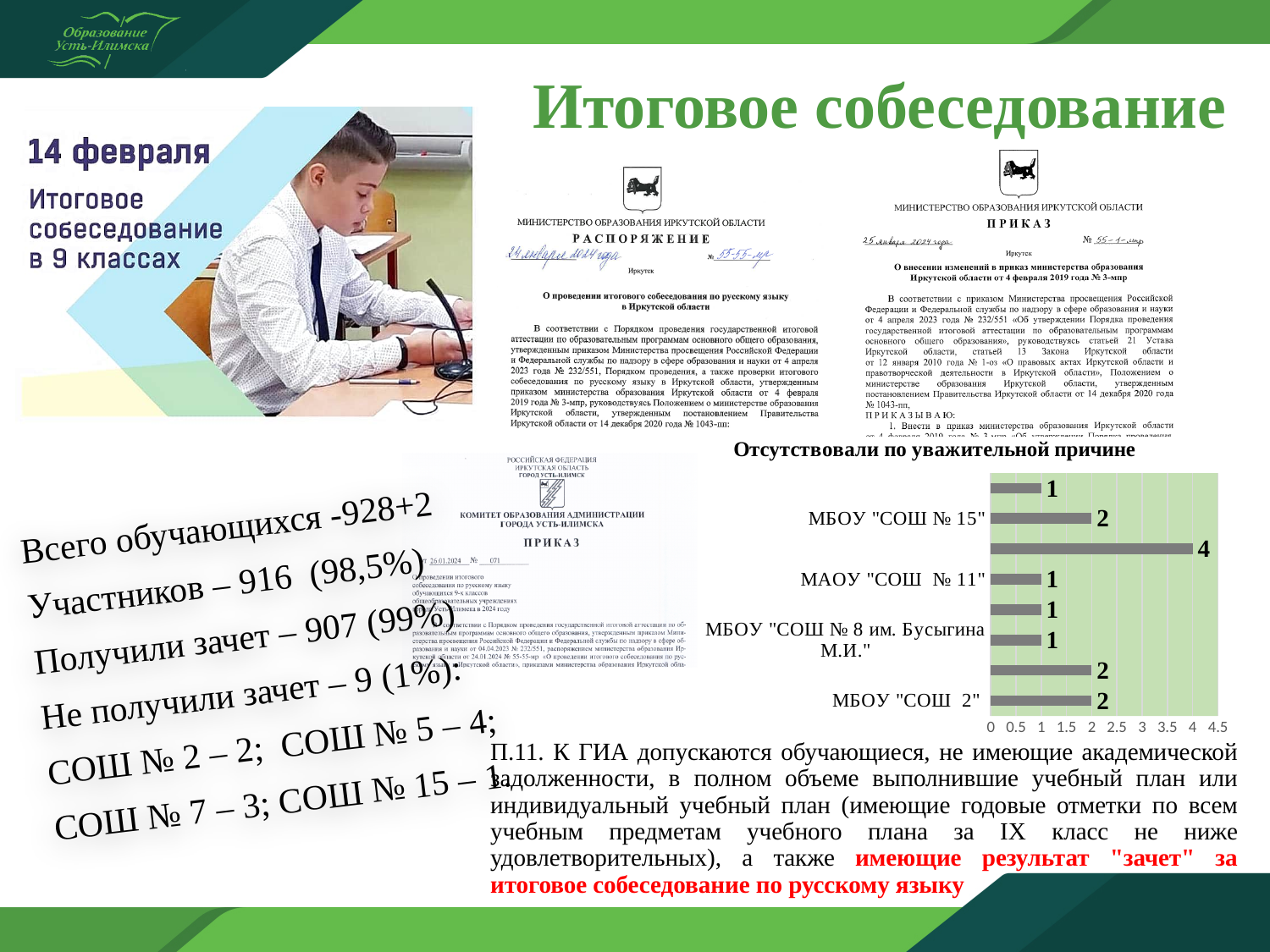
In the chart "Отсутствовали по уважительной причине", what is the value for МБОУ "СОШ № 8 им. Бусыгина М.И."? 1 In the chart "Отсутствовали по уважительной причине", is the value for МБОУ "СОШ № 15" greater or less than 1.5? greater In the chart "Отсутствовали по уважительной причине", what is the value for МАОУ "СОШ № 11"? 1 In the chart "Отсутствовали по уважительной причине", which has the larger value: МБОУ "СОШ № 15" or МАОУ "СОШ № 11"? МБОУ "СОШ № 15" In the chart "Отсутствовали по уважительной причине", how many bars are plotted? 8 In the chart "Отсутствовали по уважительной причине", what is the largest value shown on any bar? 4 In the chart "Отсутствовали по уважительной причине", what is the highest tick value shown on the horizontal axis? 4.5 In the chart "Отсутствовали по уважительной причине", what is the value for МБОУ "СОШ 2"? 2 In the chart "Отсутствовали по уважительной причине", what is the difference between the values for МБОУ "СОШ № 15" and МАОУ "СОШ № 11"? 1 In the chart "Отсутствовали по уважительной причине", what is the value for МБОУ "СОШ № 15"? 2 What is the title of the chart on the right side of the slide? Отсутствовали по уважительной причине What kind of chart is shown under the heading "Отсутствовали по уважительной причине"? bar chart